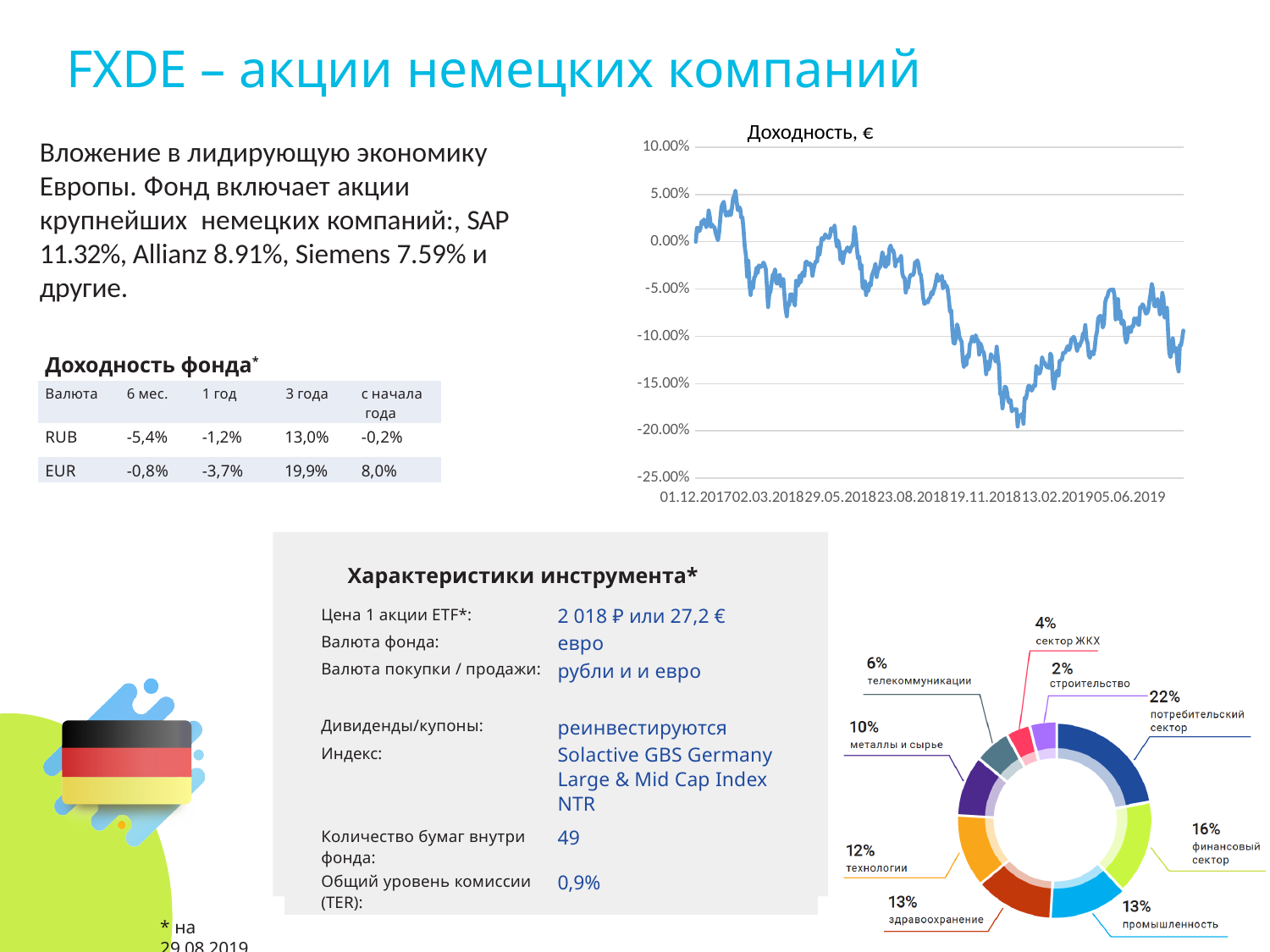
In the sector donut chart at the bottom right, how many sectors are shown? 9 In the 'Доходность, €' line chart, is the lowest point of the line greater or less than -15.00%? less In the sector donut chart at the bottom right, which has the larger share: 'технологии' or 'металлы и сырье'? технологии In the sector donut chart at the bottom right, which sector has the smallest share? строительство What is the title of the line chart at the top right of the slide? Доходность, € In the 'Доходность, €' line chart, does the line overall rise or fall from the start of the period to the end? fall In the sector donut chart at the bottom right, what share does 'потребительский сектор' have? 22% In the 'Доходность, €' line chart, is the value at the end of the series (June 2019) greater or less than -5.00%? less In the sector donut chart at the bottom right, what is the difference in percentage points between 'потребительский сектор' and 'финансовый сектор'? 6 percentage points In the sector donut chart at the bottom right, which sector has the largest share? потребительский сектор In the sector donut chart at the bottom right, what share does 'здравоохранение' have? 13% What kind of chart is the 'Доходность, €' chart at the top right of the slide? line chart